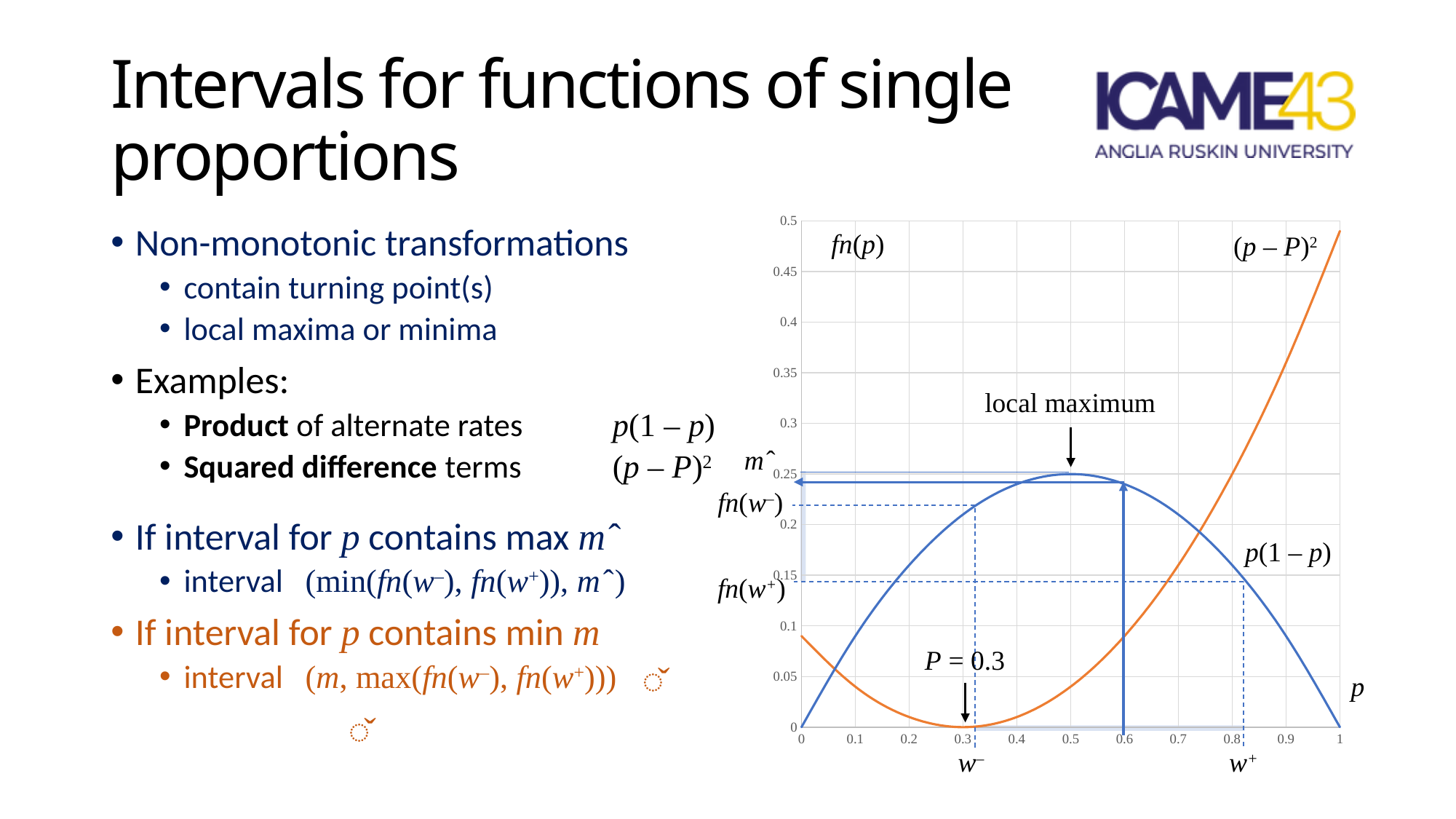
What is the label on the x axis of the chart? p How many curves are plotted on the chart? 2 At p = 1, which curve is higher, p(1 − p) or (p − P)²? (p − P)² Is the value of (p − P)² at p = 1 greater or less than 0.45? greater What is the value of (p − P)² at P = 0.3? 0 What kind of chart is shown on the slide? line chart What colour is the p(1 − p) curve? blue What is the value of p(1 − p) at its local maximum? 0.25 At p = 0.5, which curve is higher, p(1 − p) or (p − P)²? p(1 − p) At what value of p does the local maximum of p(1 − p) occur? 0.5 Does the (p − P)² curve rise or fall as p increases from 0.3 to 1? rise